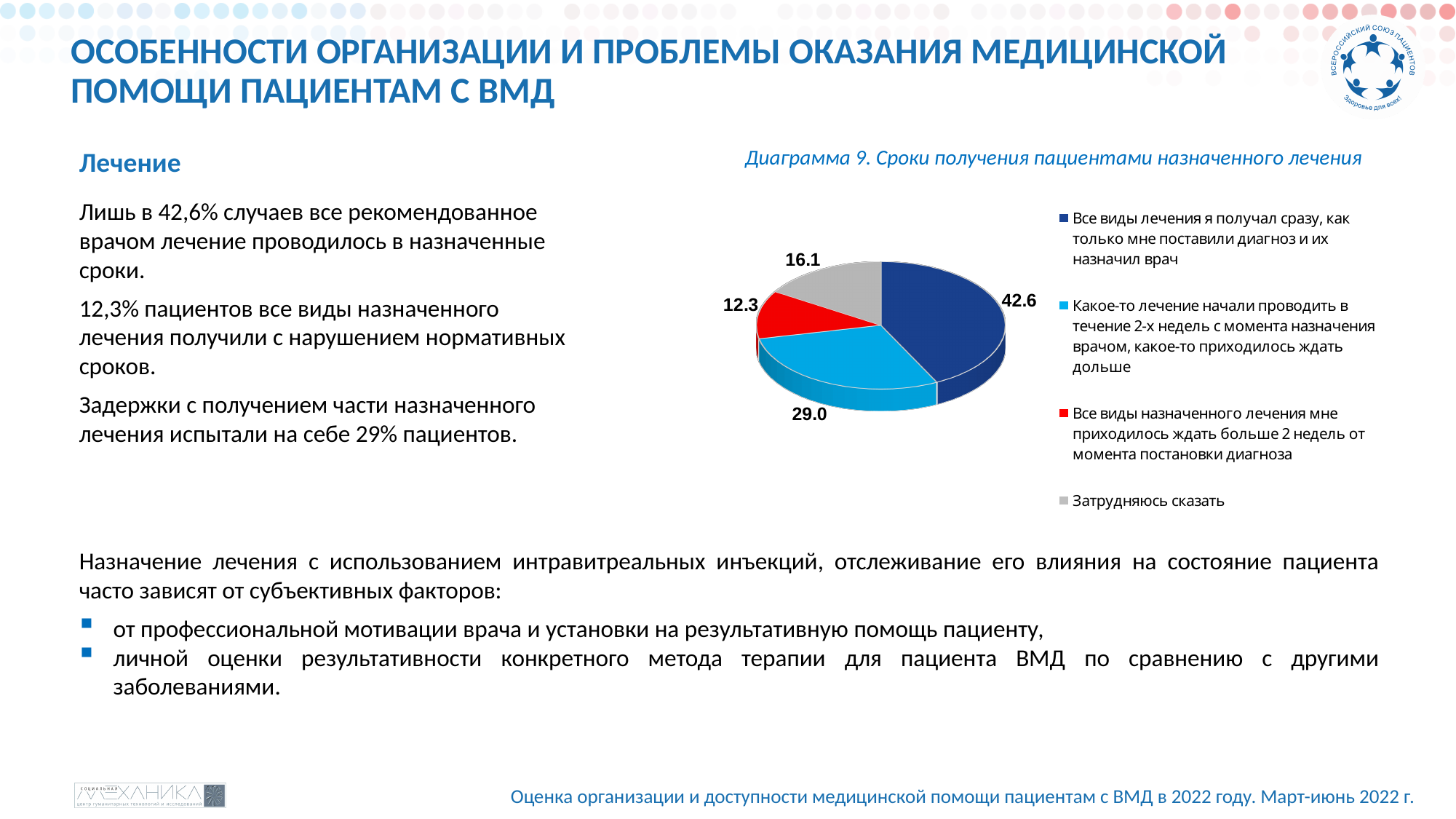
What is the value for the slice 'Все виды лечения я получал сразу, как только мне поставили диагноз и их назначил врач'? 42.6 Which is larger: the 'Затрудняюсь сказать' slice or the slice for waiting more than 2 weeks for all types of treatment? Затрудняюсь сказать Which category has the smallest slice in the pie chart? Все виды назначенного лечения мне приходилось ждать больше 2 недель от момента постановки диагноза What is the value for the slice 'Все виды назначенного лечения мне приходилось ждать больше 2 недель от момента постановки диагноза'? 12.3 What is the value for the slice 'Затрудняюсь сказать'? 16.1 What is the difference between the 'Затрудняюсь сказать' slice and the slice for waiting more than 2 weeks for all treatment? 3.8 What is the title of the chart on the slide? Диаграмма 9. Сроки получения пациентами назначенного лечения What is the difference between the largest slice (42.6) and the slice labelled 29.0? 13.6 What is the value for the slice 'Какое-то лечение начали проводить в течение 2-х недель с момента назначения врачом, какое-то приходилось ждать дольше'? 29.0 What type of chart is shown in Diagram 9? Pie chart Which category has the largest slice in the pie chart? Все виды лечения я получал сразу, как только мне поставили диагноз и их назначил врач How many slices does the pie chart have? 4